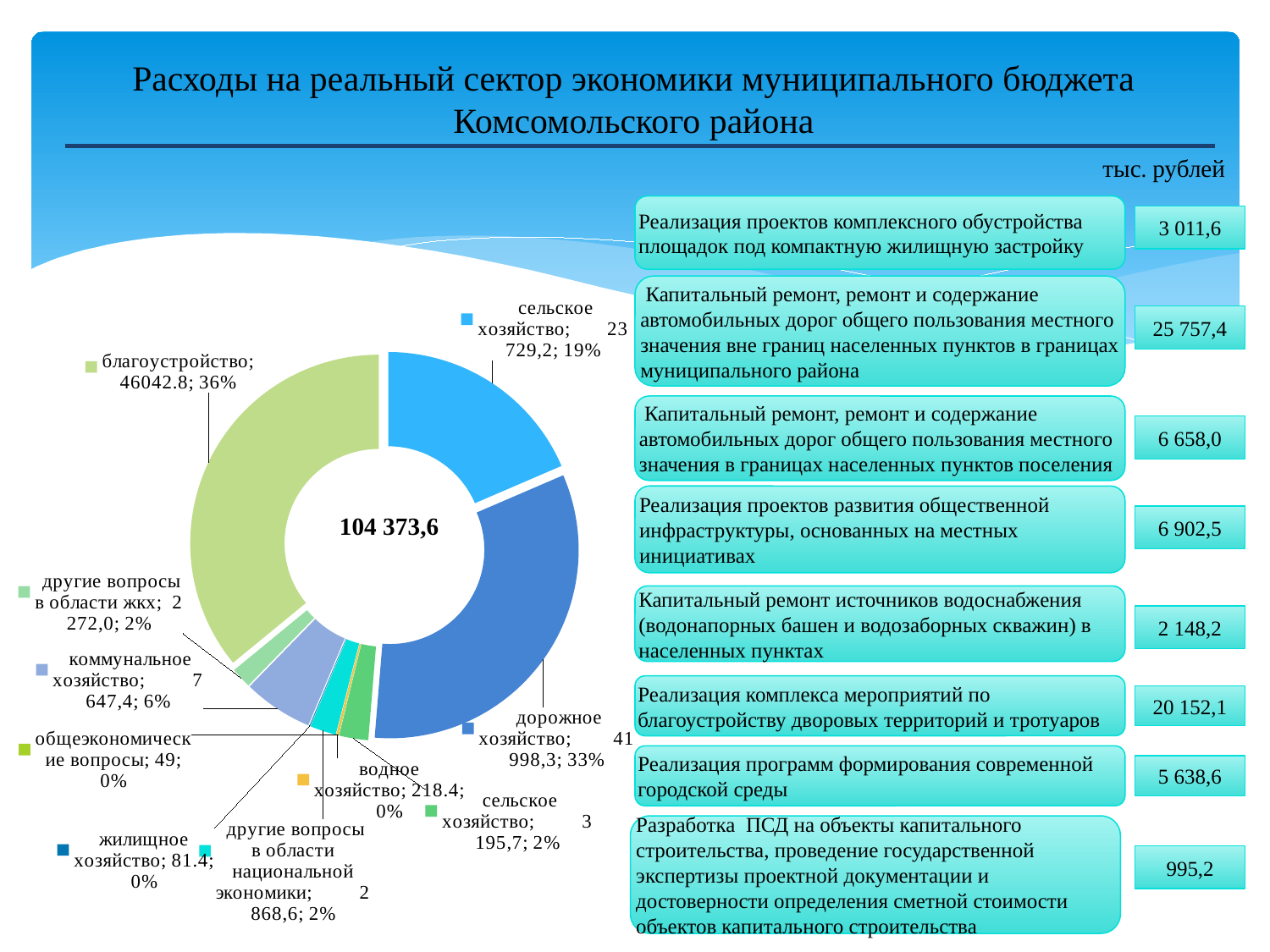
What is the value shown for дорожное хозяйство? 41 998,3 What kind of chart is shown on the slide? doughnut chart What share of the doughnut does дорожное хозяйство account for? 33% What is the value shown for благоустройство? 46042.8 How many categories are shown in the doughnut chart? 10 What total value is printed in the centre of the doughnut chart? 104 373,6 What is the value shown for коммунальное хозяйство? 7 647,4 What share of the doughnut does благоустройство account for? 36% Which category has the largest slice of the doughnut? благоустройство Which is larger: дорожное хозяйство or коммунальное хозяйство? дорожное хозяйство Which category has the smallest value in the doughnut chart? общеэкономические вопросы What is the difference between коммунальное хозяйство and другие вопросы в области жкх? 5 375,4